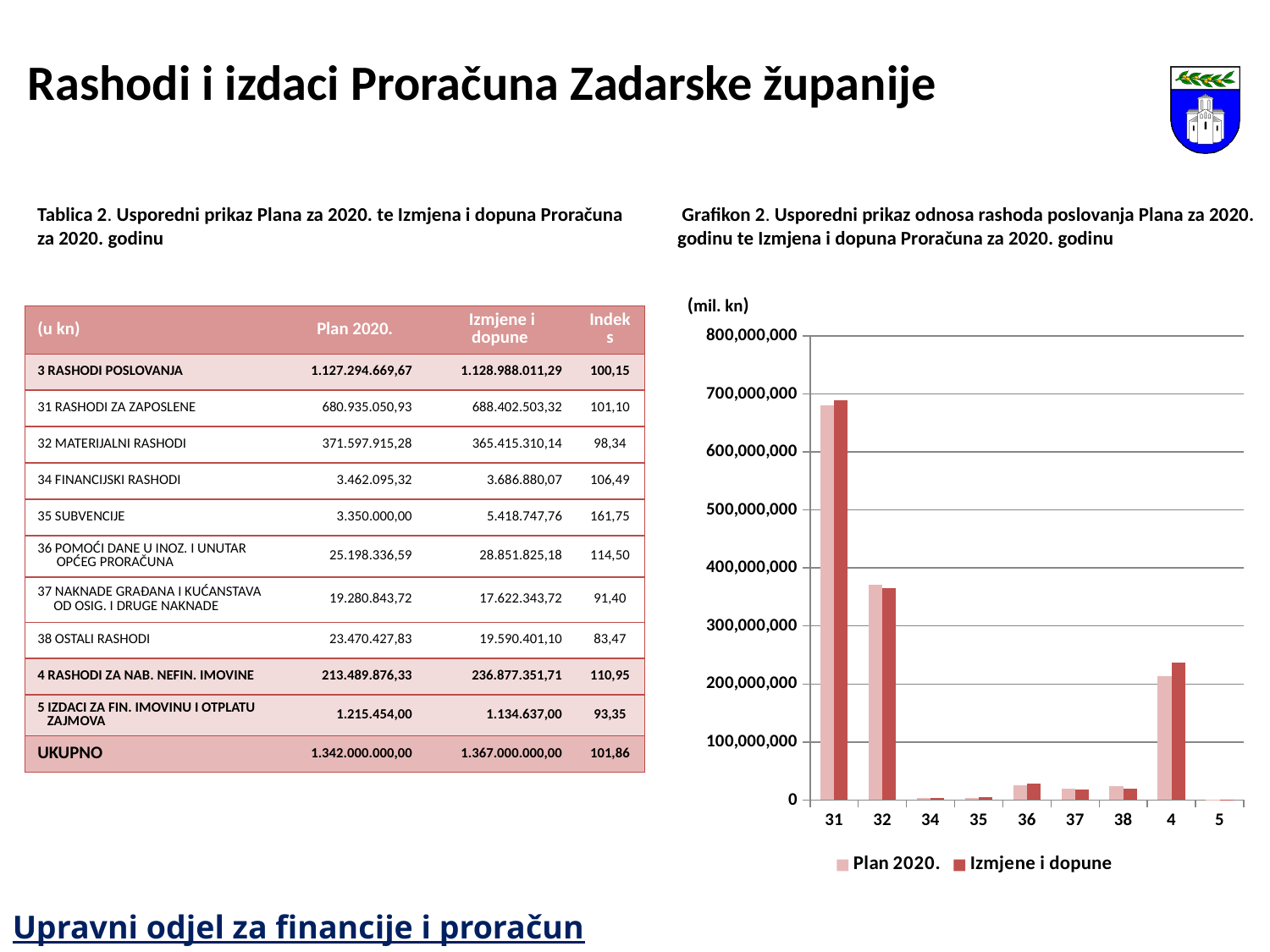
Which category has the lowest bars in the chart? 5 Which category has the highest Plan 2020. bar in the chart? 31 What are the two series named in the chart legend? Plan 2020. and Izmjene i dopune What kind of chart is Grafikon 2 on the slide? bar chart In the chart, is the Plan 2020. bar for category 31 greater or less than 600,000,000? greater Which category has the highest Izmjene i dopune bar in the chart? 31 How many categories are shown on the x axis of the chart? 9 In the chart, which is larger for category 4: the Plan 2020. bar or the Izmjene i dopune bar? Izmjene i dopune In the chart, is the Izmjene i dopune bar for category 32 greater or less than 400,000,000? less In the chart, which category has a larger Plan 2020. bar: 31 or 32? 31 How many series does the legend of the chart list? 2 In the chart, is the Plan 2020. bar for category 38 greater or less than 100,000,000? less